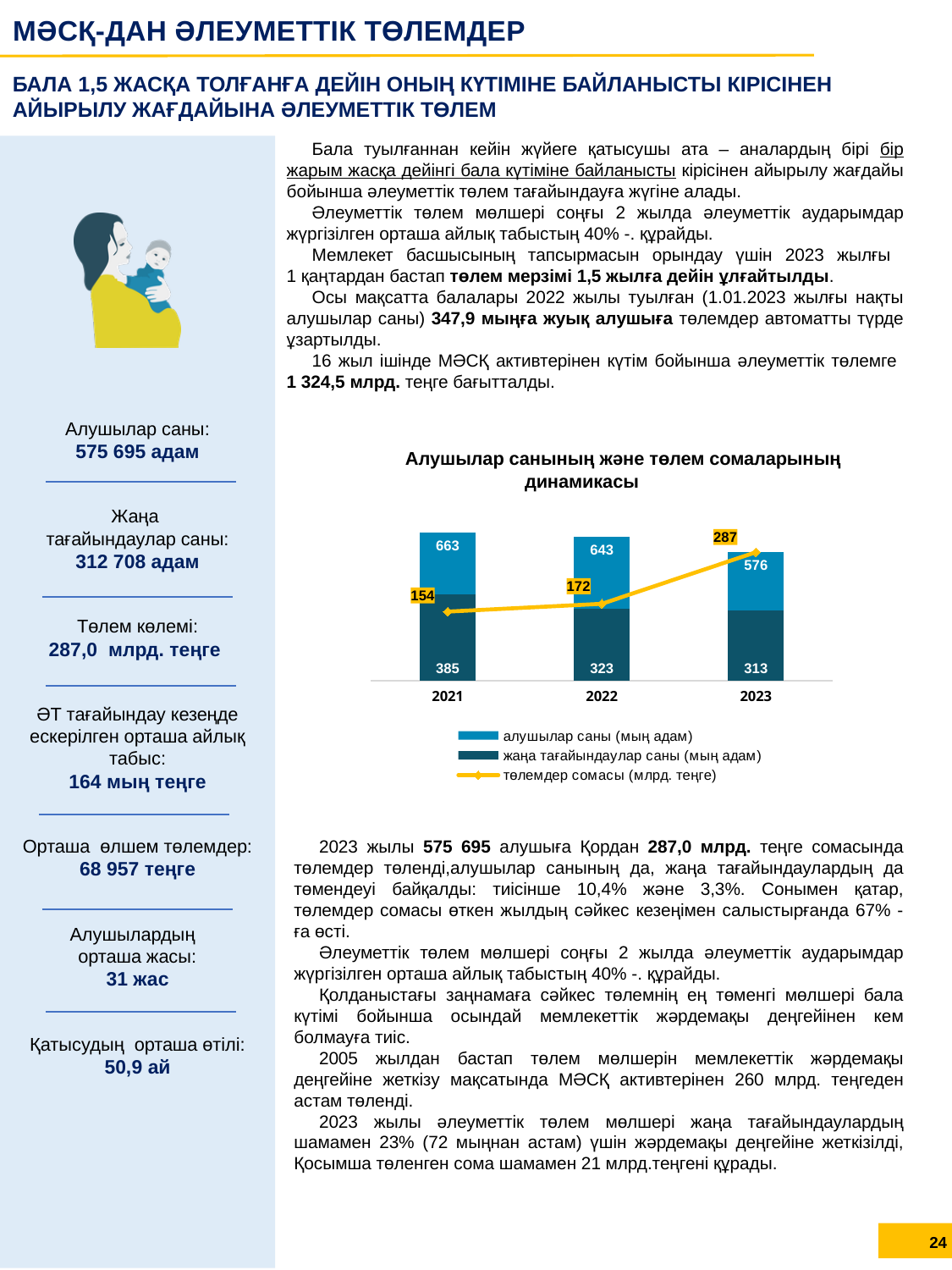
How many series does the chart legend list? 3 How many years are shown on the x axis of the chart? 3 In which year is алушылар саны (мың адам) lowest? 2023 What is the value of жаңа тағайындаулар саны (мың адам) for 2023? 313 What is the value of алушылар саны (мың адам) for 2021? 663 Does төлемдер сомасы (млрд. теңге) rise or fall from 2021 to 2023? Rise Which is larger: жаңа тағайындаулар саны (мың адам) in 2021 or in 2022? 2021 In which year is төлемдер сомасы (млрд. теңге) highest? 2023 What is the difference between алушылар саны (мың адам) in 2021 and 2023? 87 What is the title of the chart? Алушылар санының және төлем сомаларының динамикасы What is the value of төлемдер сомасы (млрд. теңге) for 2022? 172 What kind of chart is used to show алушылар саны and жаңа тағайындаулар саны? Stacked bar chart